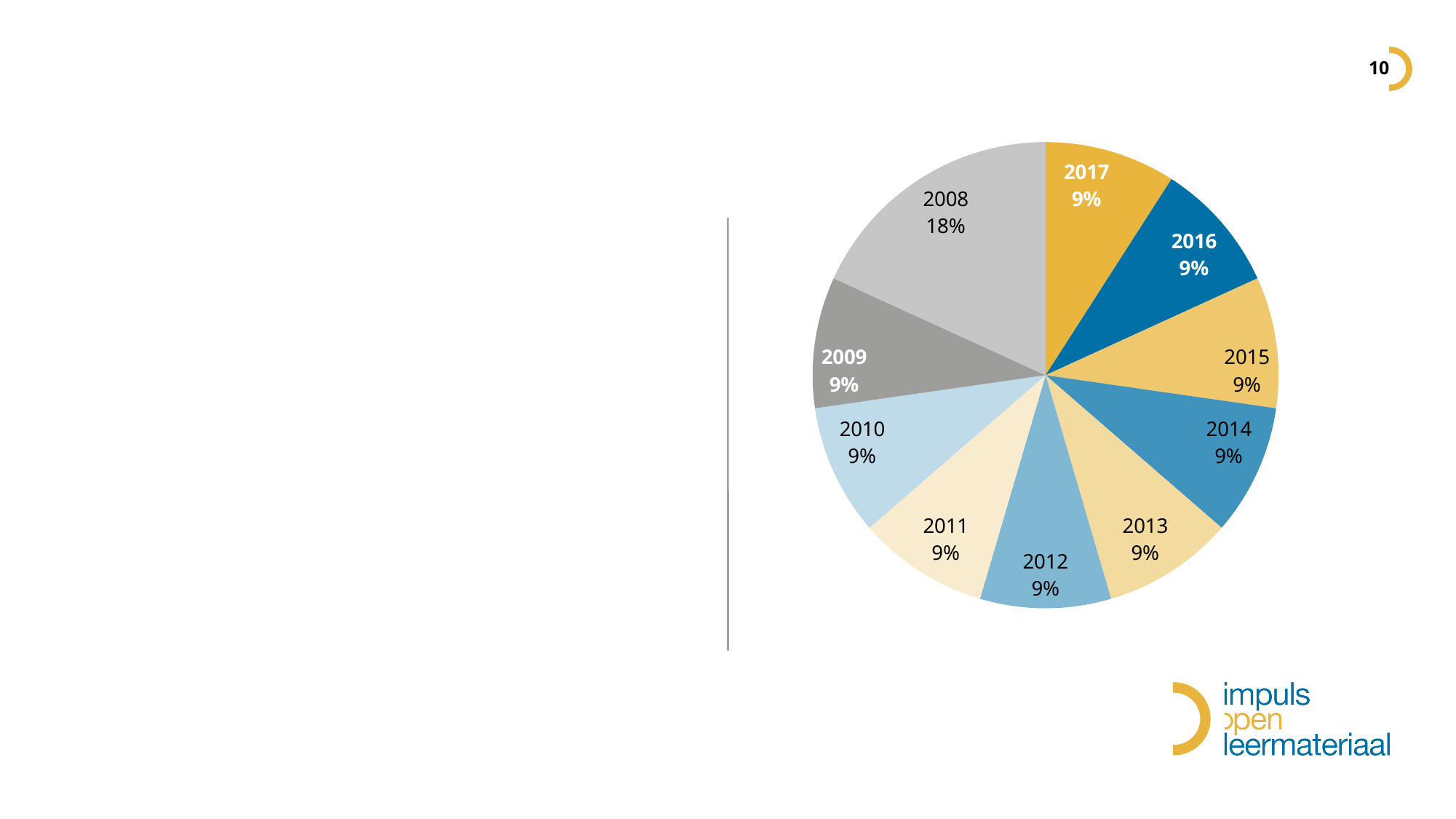
Which year has the largest slice in the pie chart? 2008 How many slices does the pie chart have? 10 What share of the pie does the 2012 slice represent? 9% What share of the pie does the 2008 slice represent? 18% What is the difference between the shares for 2008 and 2009? 9% What is the value shown for 2010 in the pie chart? 9% Which year's slice is shown in the darkest grey colour? 2009 What is the earliest year labelled on the pie chart? 2008 Which is larger, the slice for 2008 or the slice for 2015? 2008 What is the value shown for 2017 in the pie chart? 9% What is the combined share of the 2016 and 2017 slices? 18% What kind of chart is shown on the slide? pie chart